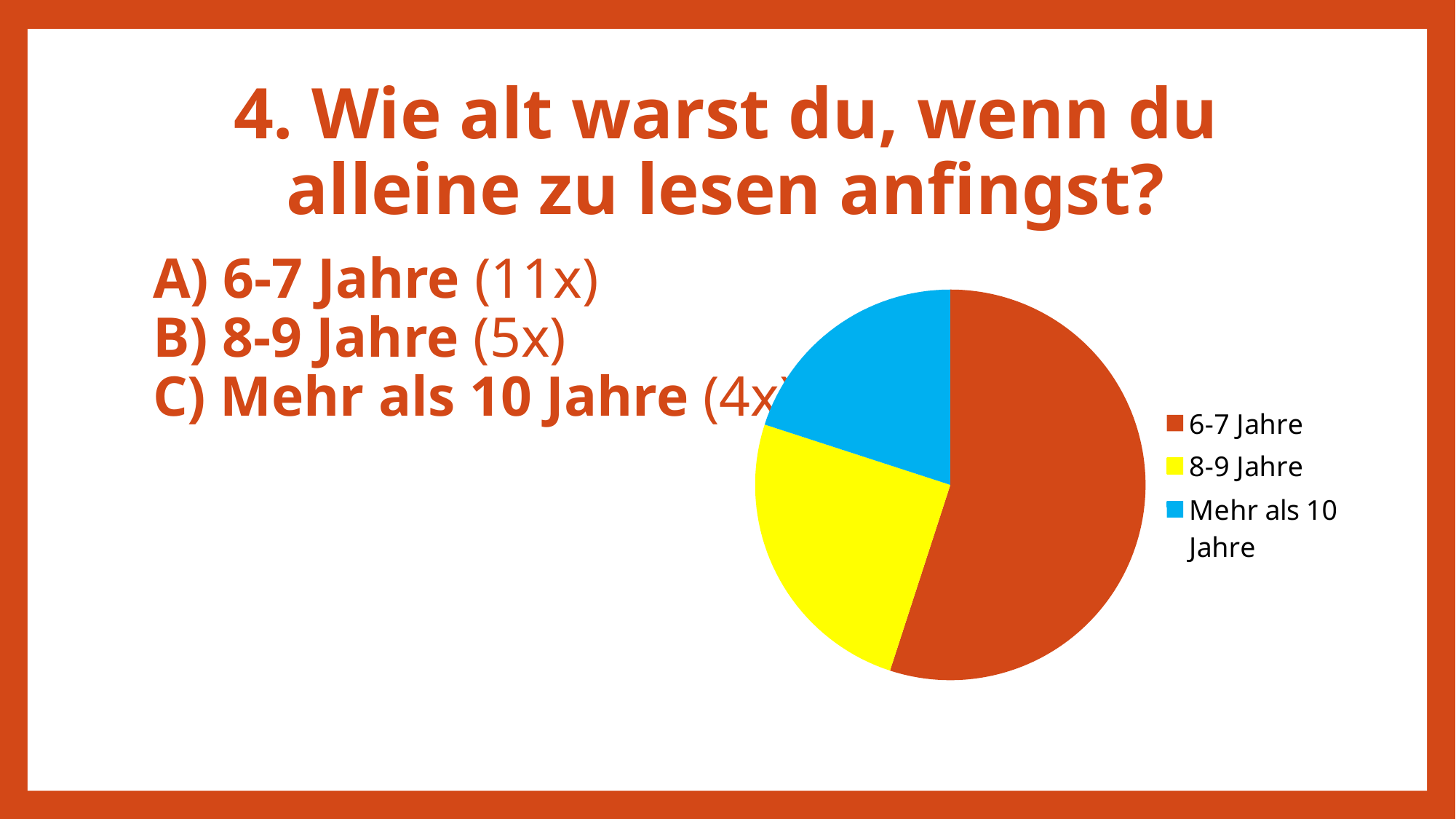
How many slices does the pie chart have? 3 Which colour represents 8-9 Jahre in the pie chart? yellow Which category has the smallest slice in the pie chart? Mehr als 10 Jahre How many entries does the legend of the pie chart list? 3 What kind of chart is shown on the slide? pie chart What share of the pie does the 6-7 Jahre slice represent? 55% How many responses does the slide give for the category 8-9 Jahre? 5x How many responses does the slide give for the category 6-7 Jahre? 11x How many more responses does 6-7 Jahre have than 8-9 Jahre? 6 Which category has more responses, 8-9 Jahre or Mehr als 10 Jahre? 8-9 Jahre How many responses does the slide give for the category Mehr als 10 Jahre? 4x Which category has the largest slice in the pie chart? 6-7 Jahre